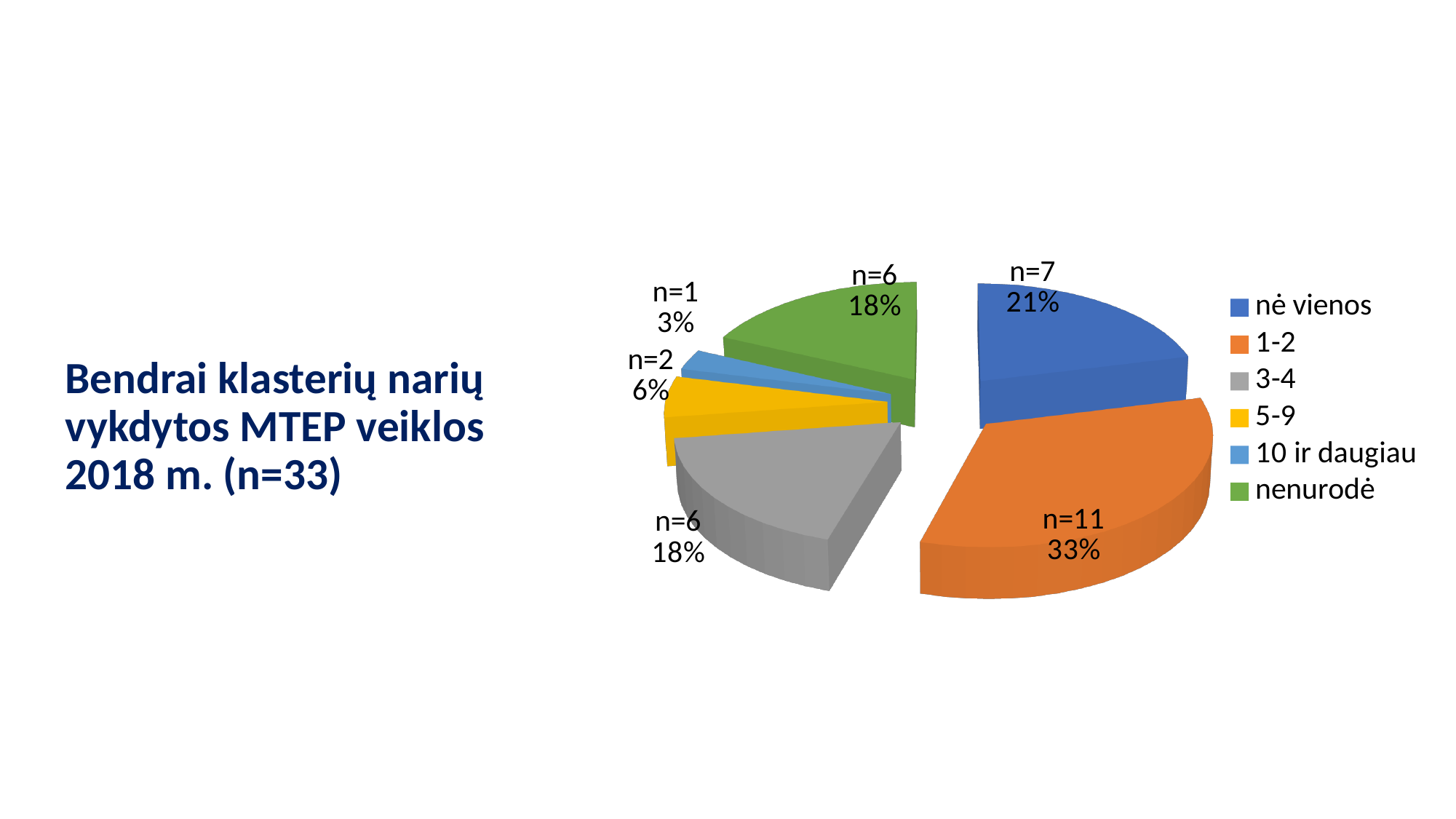
Which is larger, the '3-4' slice or the '5-9' slice? 3-4 How many categories does the legend list? 6 What percentage share does the '10 ir daugiau' slice have? 3% What is the n value for the '5-9' slice? n=2 Which category has the largest slice? 1-2 What is the n value for the 'nė vienos' slice? n=7 What kind of chart is shown on the slide? pie chart What percentage share does the 'nė vienos' slice have? 21% Which category has the smallest slice? 10 ir daugiau What is the difference in n between the '1-2' slice and the 'nė vienos' slice? 4 What percentage share does the '1-2' slice have? 33% What colour is the 'nenurodė' slice? green